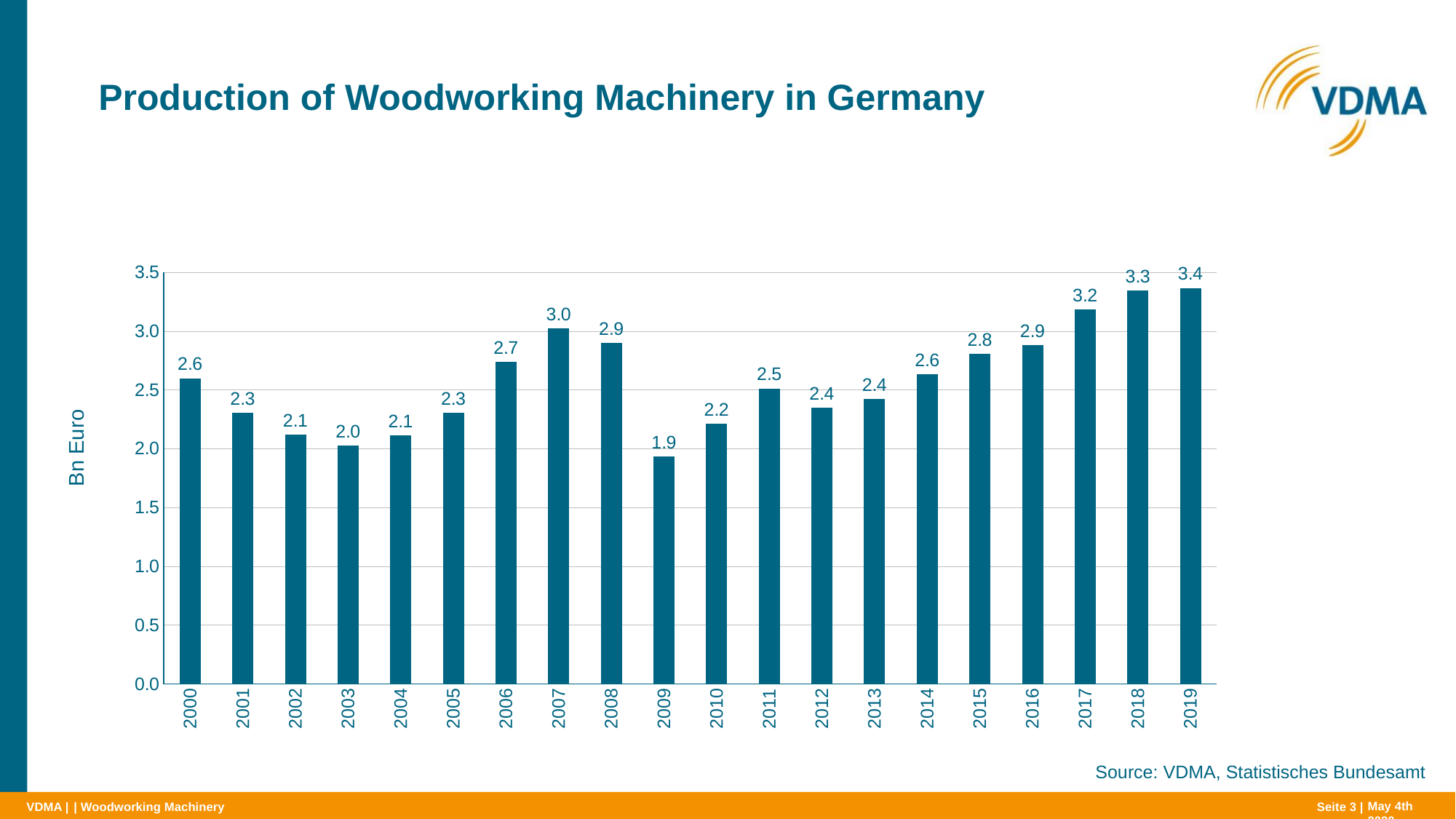
What kind of chart is shown on the slide? bar chart What is the production value for 2009? 1.9 What is the production value for 2007? 3.0 What is the production value for 2019? 3.4 Which is larger, the value for 2006 or the value for 2010? 2006 Is the value for 2017 greater or less than 3.0? greater Do the values rise or fall from 2009 to 2019? rise What is the label of the y axis? Bn Euro How many years are shown on the x axis? 20 Which year has the highest production value? 2019 Which year has the lowest production value? 2009 What is the difference between the values for 2019 and 2009? 1.5